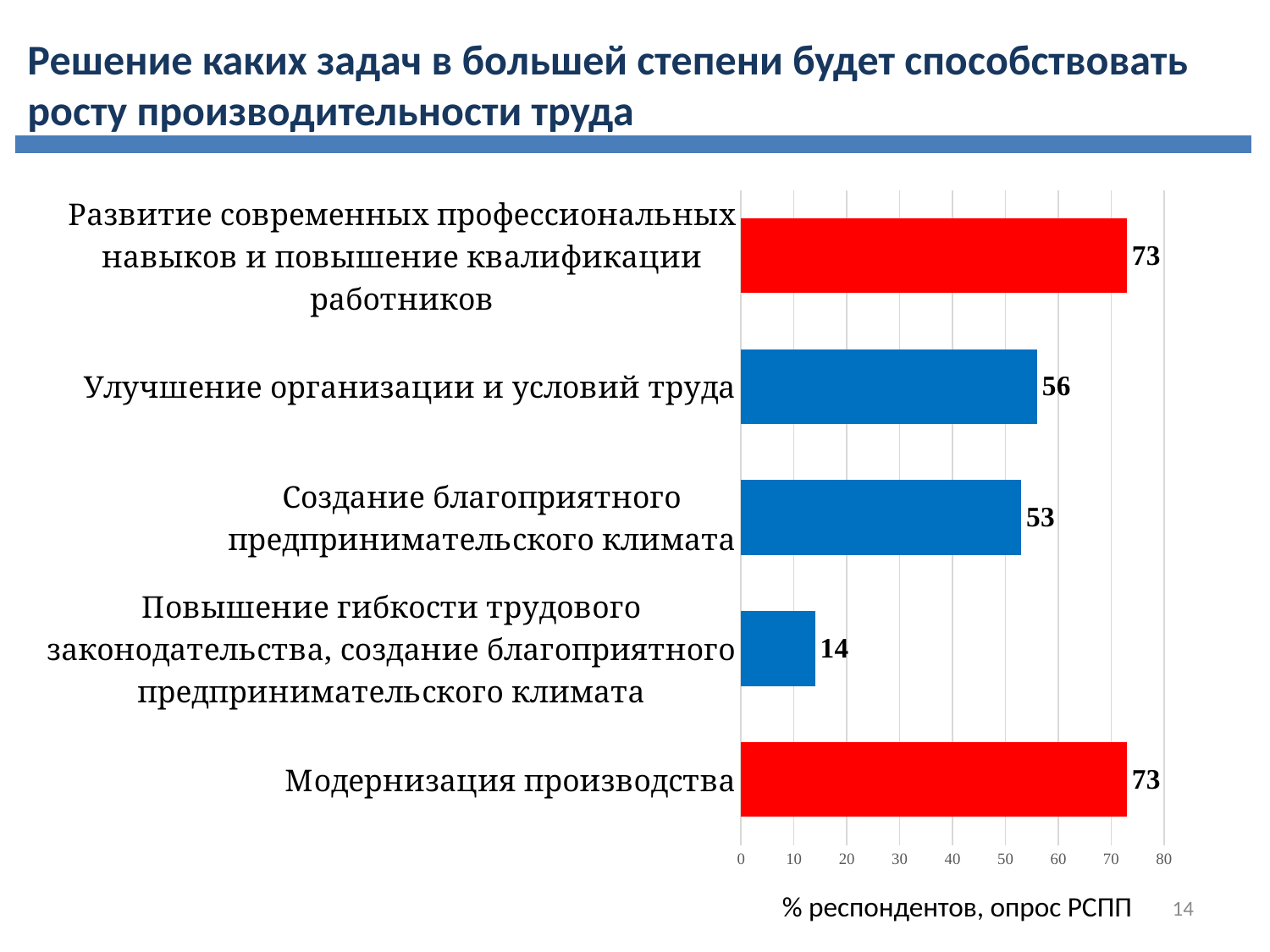
Which category has the lowest value? Повышение гибкости трудового законодательства, создание благоприятного предпринимательского климата What is the difference between the values for «Модернизация производства» and «Повышение гибкости трудового законодательства, создание благоприятного предпринимательского климата»? 59 What is the value for «Создание благоприятного предпринимательского климата»? 53 What kind of chart is shown on the slide? bar chart Which is larger: the value for «Улучшение организации и условий труда» or for «Создание благоприятного предпринимательского климата»? Улучшение организации и условий труда What is the value for «Повышение гибкости трудового законодательства, создание благоприятного предпринимательского климата»? 14 What is the difference between the values for «Улучшение организации и условий труда» and «Создание благоприятного предпринимательского климата»? 3 Is the value for «Развитие современных профессиональных навыков и повышение квалификации работников» greater or less than 70? greater How many categories are shown in the chart? 5 What is the value for «Модернизация производства»? 73 What colour are the bars for the two categories with a value of 73? red What is the value for «Улучшение организации и условий труда»? 56